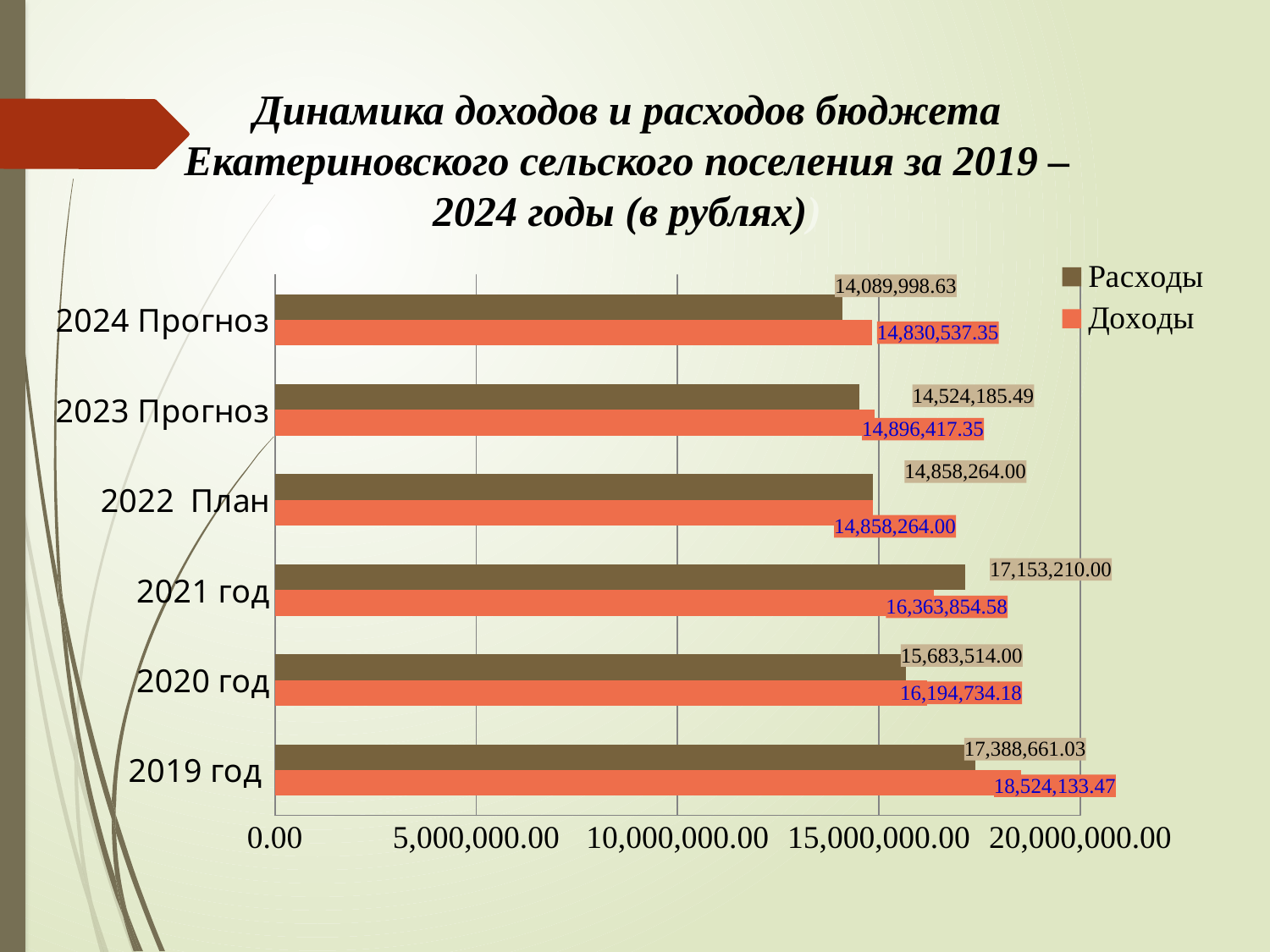
What is the difference between Доходы and Расходы for 2019 год? 1,135,472.44 What is the difference between Расходы and Доходы for 2021 год? 789,355.42 Is the Расходы value for 2024 Прогноз greater or less than 15,000,000.00? less Which category has the lowest Расходы value? 2024 Прогноз What is the value of Доходы for 2023 Прогноз? 14,896,417.35 What is the value of Расходы for 2024 Прогноз? 14,089,998.63 Which category has the highest Доходы value? 2019 год What kind of chart is shown on the slide? bar chart For 2021 год, which is larger: Расходы or Доходы? Расходы How many series does the legend list? 2 What is the value of Доходы for 2019 год? 18,524,133.47 How many categories are shown on the chart? 6